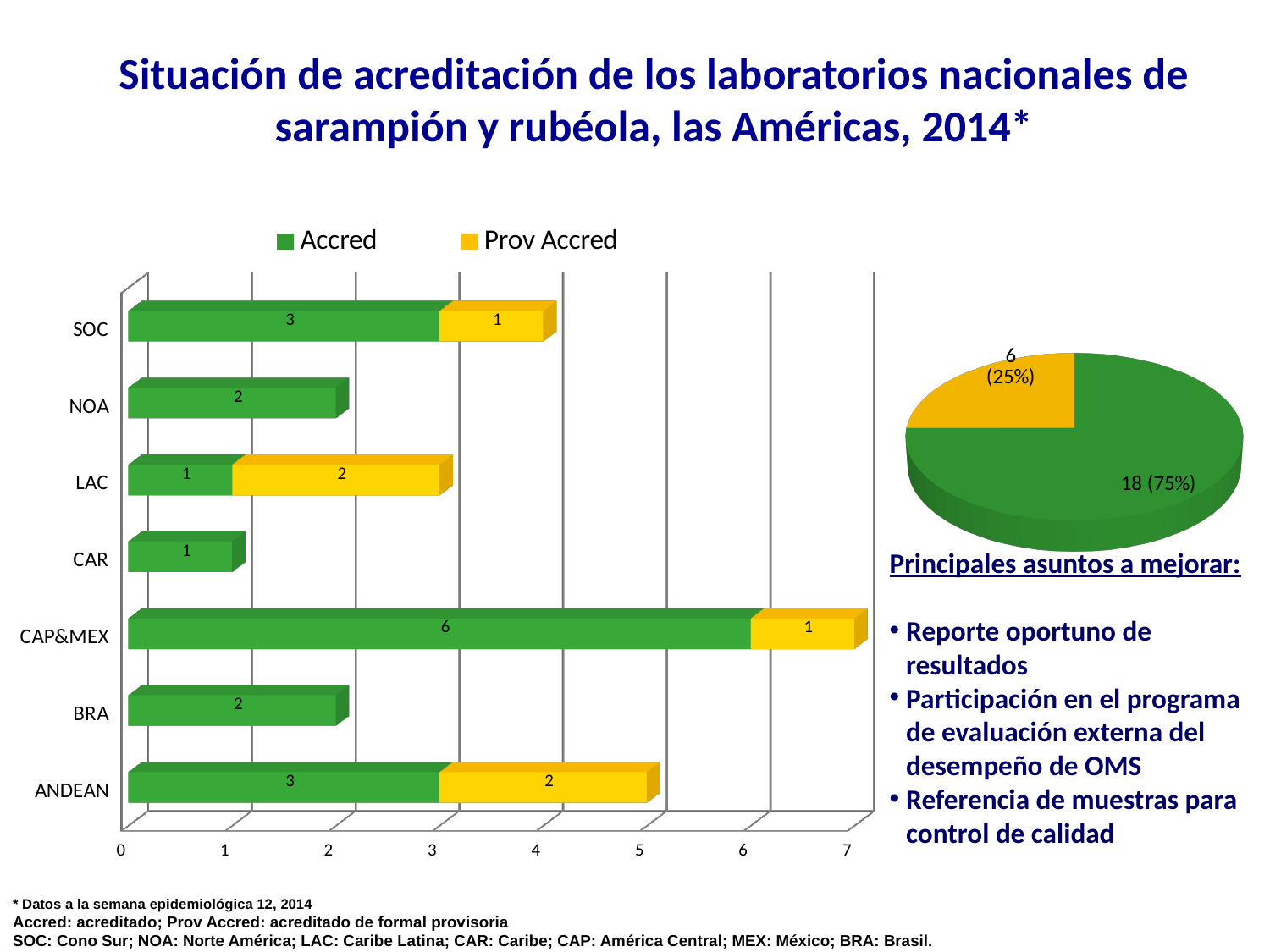
In the bar chart, what is the Accred value for SOC? 3 How many series does the legend of the bar chart list? 2 In the pie chart, what share does the yellow slice represent? 25% In the bar chart, what is the total of the stacked bar for ANDEAN? 5 In the bar chart, what is the Prov Accred value for LAC? 2 In the bar chart, what is the total of the stacked bar for CAP&MEX? 7 In the bar chart, what is the difference between the Accred values for CAP&MEX and SOC? 3 In the bar chart, which category has the highest Accred value? CAP&MEX What kind of chart is the chart on the left of the slide? Bar chart In the bar chart, which is larger: the Accred value for NOA or the Accred value for CAR? NOA How many categories are shown in the bar chart? 7 In the bar chart, what is the Accred value for CAP&MEX? 6